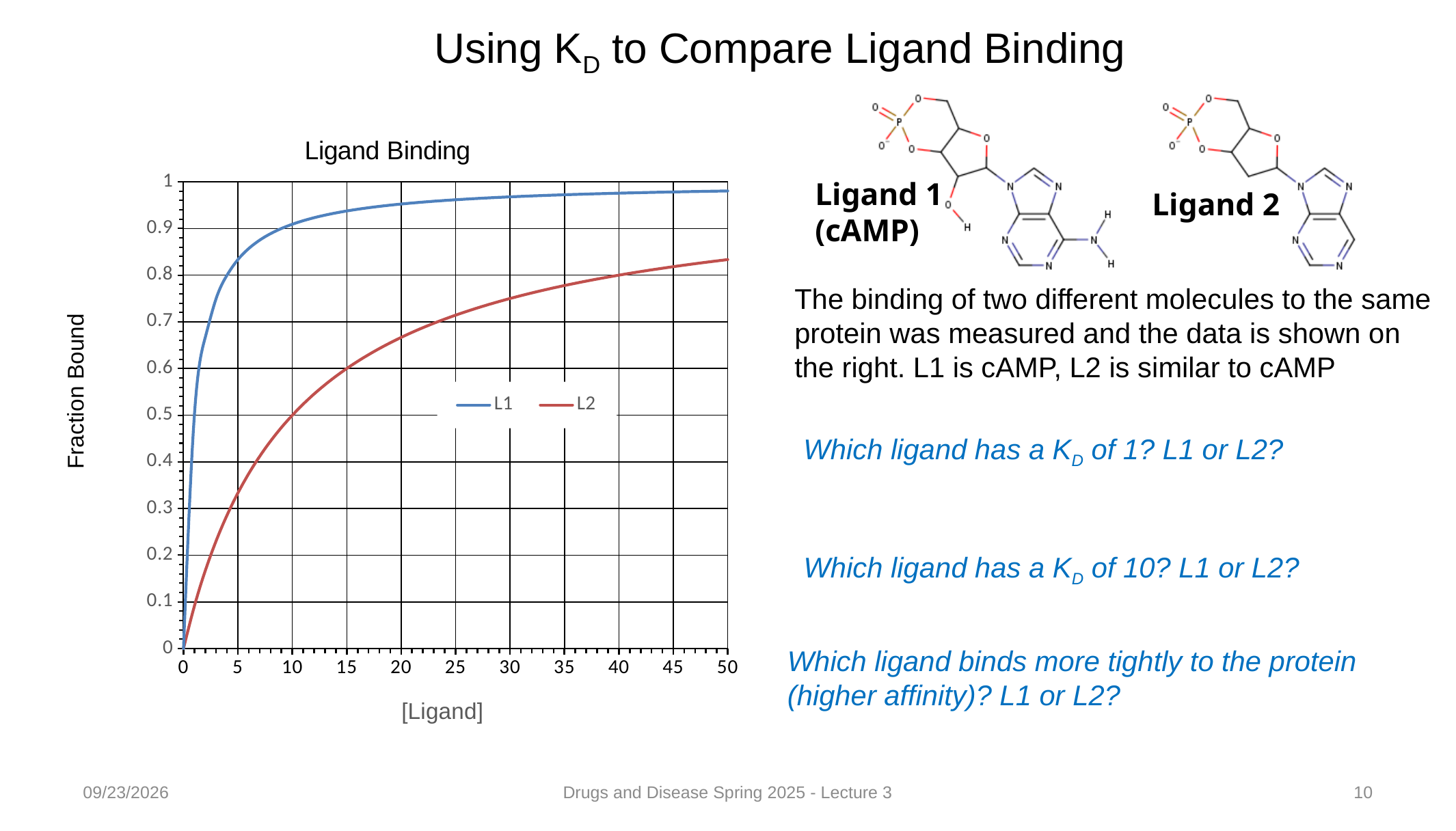
Is the Fraction Bound for L1 at [Ligand] = 20 greater or less than 0.9? greater At [Ligand] = 20, which series has the higher Fraction Bound, L1 or L2? L1 Is the Fraction Bound for L2 at [Ligand] = 50 greater or less than 0.9? less Is the Fraction Bound for L2 at [Ligand] = 5 greater or less than 0.4? less How many series does the chart's legend list? 2 What is the title of the chart? Ligand Binding Do the values for L2 rise or fall as [Ligand] increases? rise Do the values for L1 rise or fall as [Ligand] increases? rise What kind of chart is shown on the slide? line chart What is the label of the chart's vertical axis? Fraction Bound